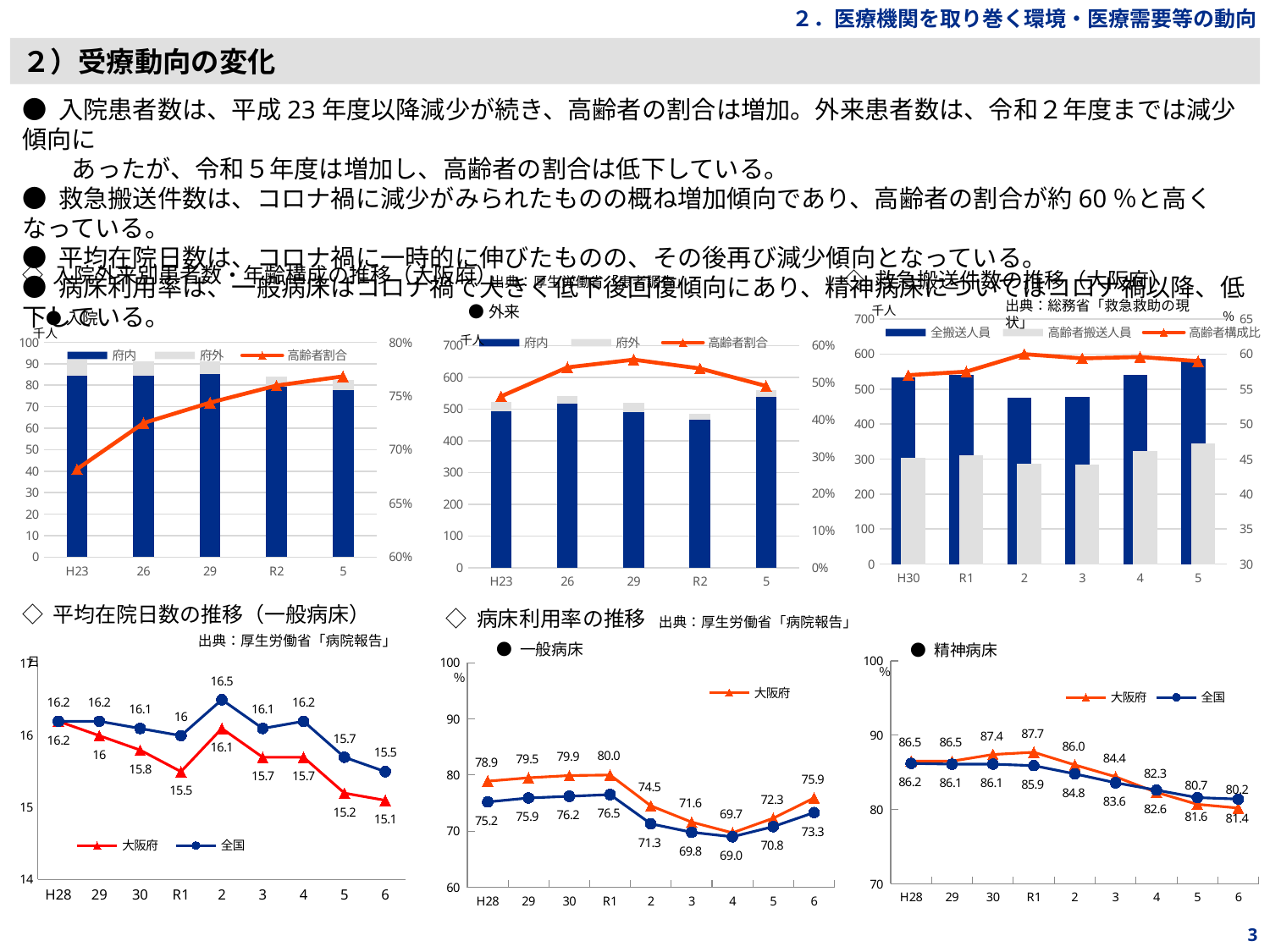
In the 病床利用率の推移 一般病床 chart, what is the difference between the 大阪府 and 全国 values for 6? 2.6 In the 病床利用率の推移 精神病床 chart, in which year is the 大阪府 value highest? R1 In the 平均在院日数の推移（一般病床） chart, what is the 大阪府 value for 6? 15.1 In the 救急搬送件数の推移（大阪府） chart, how many series does the legend list? 3 In the 病床利用率の推移 精神病床 chart, does the 大阪府 value rise or fall from R1 to 6? fall In the 病床利用率の推移 一般病床 chart, in which year is the 全国 value lowest? 4 In the 平均在院日数の推移（一般病床） chart, what is the 全国 value for R2? 16.5 In the 病床利用率の推移 一般病床 chart, what is the 大阪府 value for R1? 80.0 In the 外来 chart at the top middle, is the 高齢者割合 value for H23 greater or less than 40%? greater In the 病床利用率の推移 精神病床 chart, which is larger for 5, 大阪府 or 全国? 全国 In the 救急搬送件数の推移（大阪府） chart, how many years are shown on the x axis? 6 In the 病床利用率の推移 精神病床 chart, what is the 全国 value for 6? 81.4